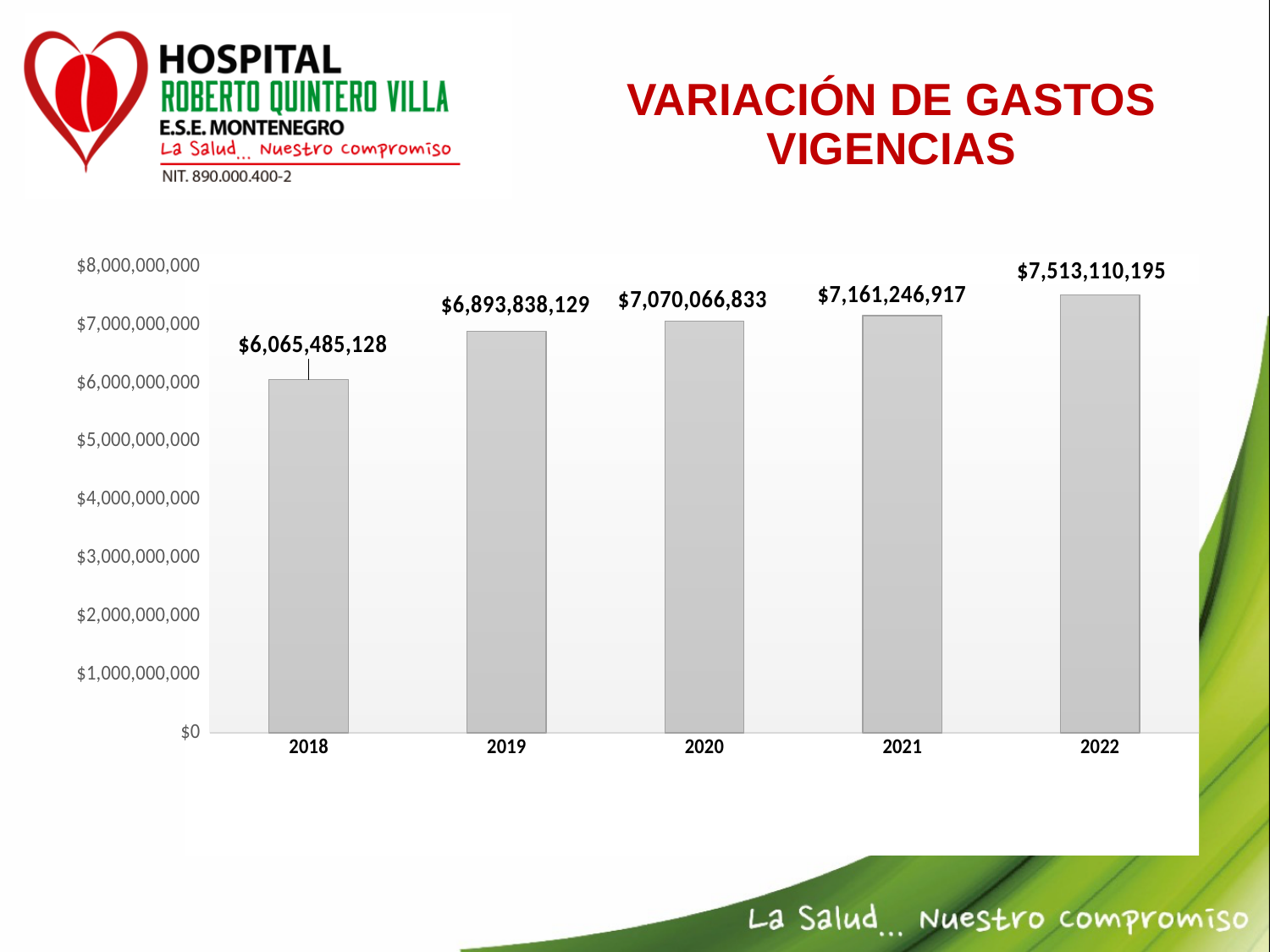
Do the values rise or fall from 2018 to 2022? rise What is the value for 2022? $7,513,110,195 What is the value for 2018? $6,065,485,128 Which year has the lowest value? 2018 Is the value for 2018 greater or less than $7,000,000,000? less What is the value for 2020? $7,070,066,833 What is the difference between the values for 2019 and 2018? $828,353,001 What kind of chart is shown on the slide? bar chart Which is larger, the value for 2021 or the value for 2019? 2021 How many years are shown on the x axis? 5 What is the difference between the values for 2022 and 2018? $1,447,625,067 Which year has the highest value? 2022